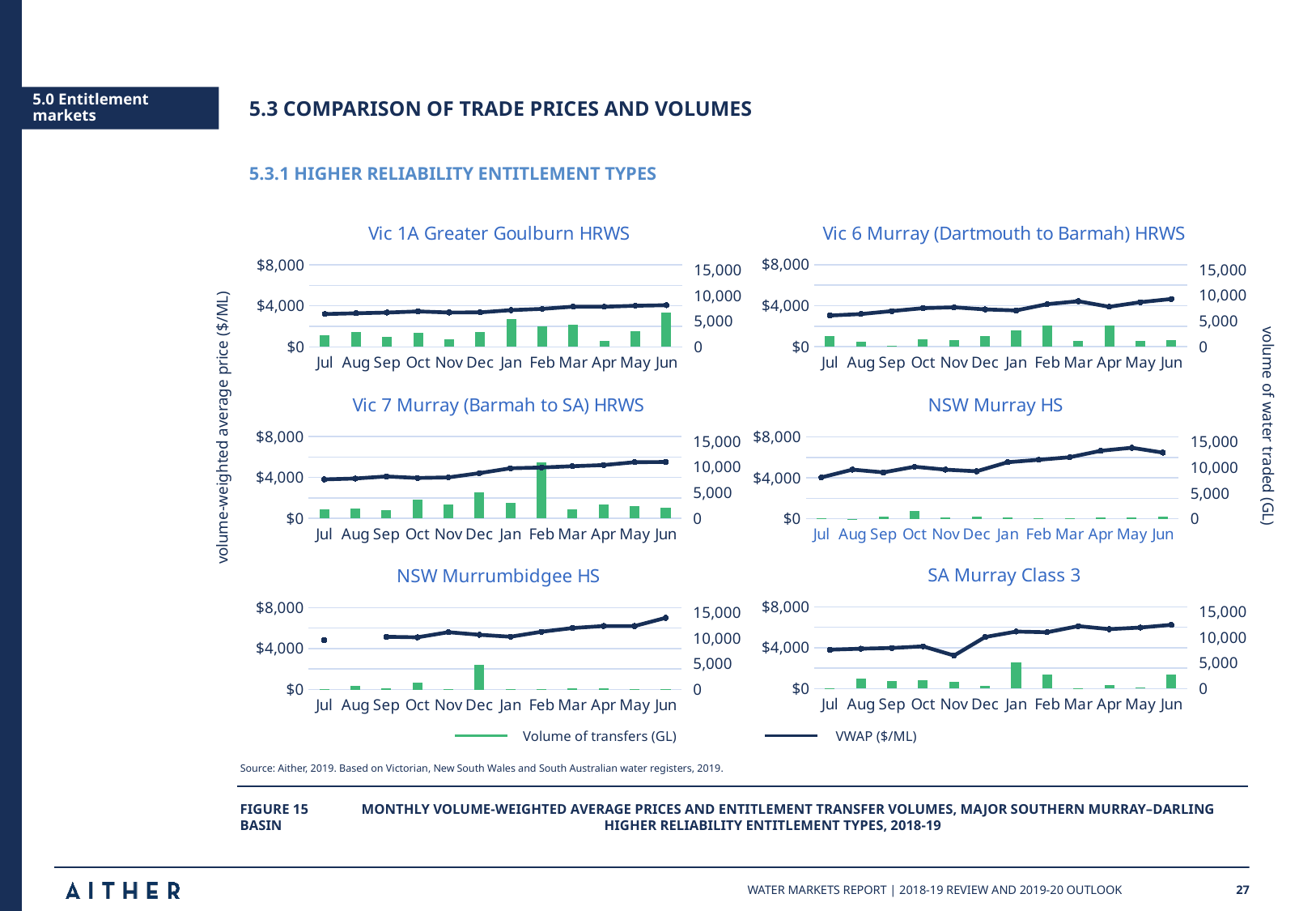
In the Vic 7 Murray (Barmah to SA) HRWS chart, is the volume of transfers for Feb greater or less than 5,000 GL? greater In the NSW Murrumbidgee HS chart, is the VWAP for Jun greater or less than $4,000? greater In the Vic 1A Greater Goulburn HRWS chart, how many months are plotted along the x axis? 12 In the NSW Murray HS chart, does the VWAP generally rise or fall from Jul to May? rise In the Vic 1A Greater Goulburn HRWS chart, is the VWAP for Jul greater or less than $4,000? less In the NSW Murray HS chart, which month has the highest VWAP? May In the Vic 7 Murray (Barmah to SA) HRWS chart, which month has the highest volume of transfers? Feb In the SA Murray Class 3 chart, which month has the lowest VWAP? Nov How many charts are shown on the slide? 6 How many series does the shared legend at the bottom of the slide list? 2 What kind of chart is the Vic 7 Murray (Barmah to SA) HRWS chart? Combined bar and line chart In the Vic 6 Murray (Dartmouth to Barmah) HRWS chart, which month has the lowest volume of transfers? Sep